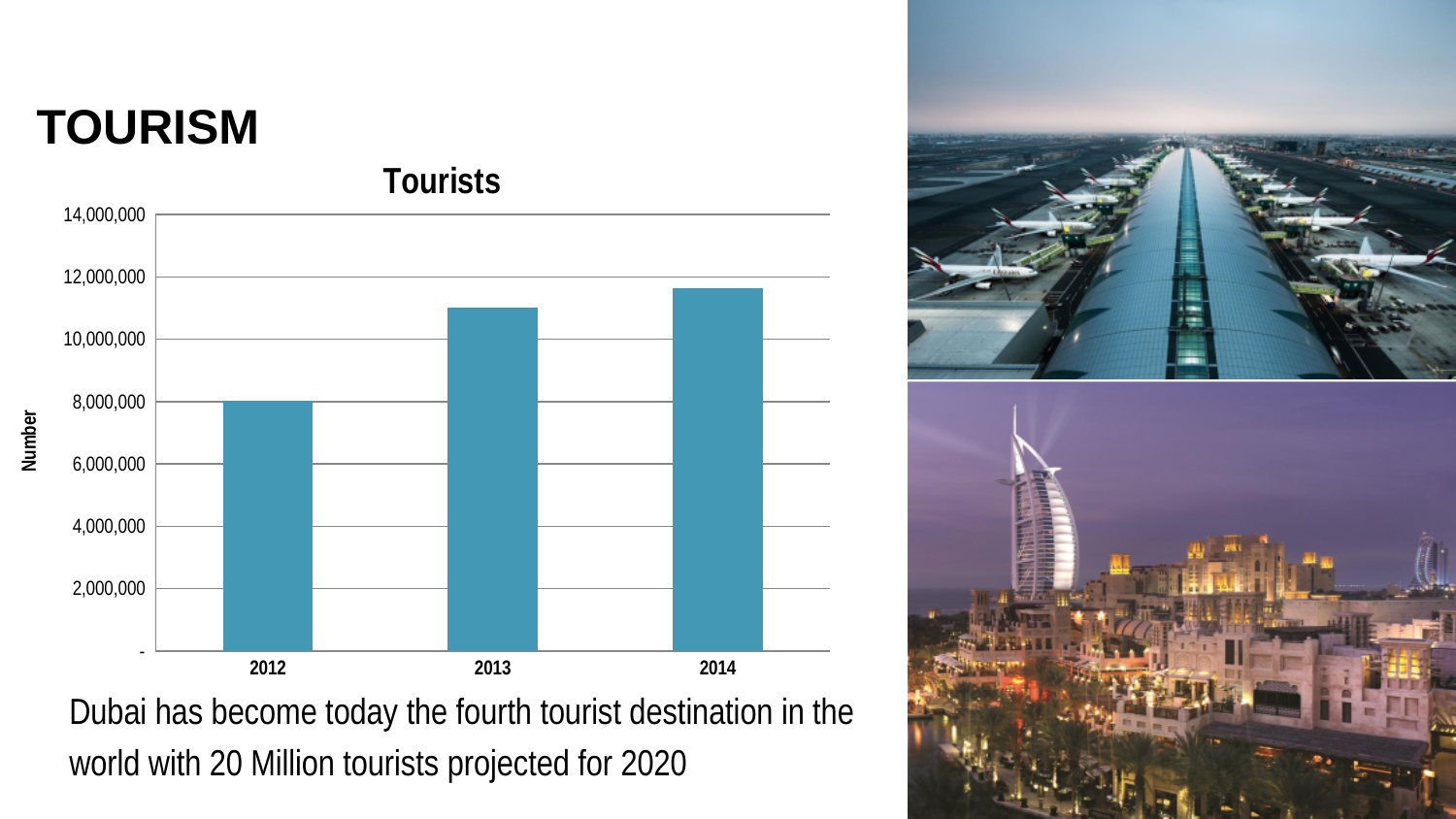
What is the label on the vertical axis of the chart? Number Which year has more tourists, 2013 or 2014? 2014 What type of chart is shown on the slide? bar chart Is the value for 2013 greater or less than 10,000,000? greater Is the value for 2014 greater or less than 12,000,000? less What is the title of the chart? Tourists Which year has the highest number of tourists? 2014 Which year has the lowest number of tourists? 2012 How many years are shown on the x axis of the chart? 3 Do the number of tourists rise or fall from 2012 to 2014? rise Is the value for 2012 greater or less than 10,000,000? less